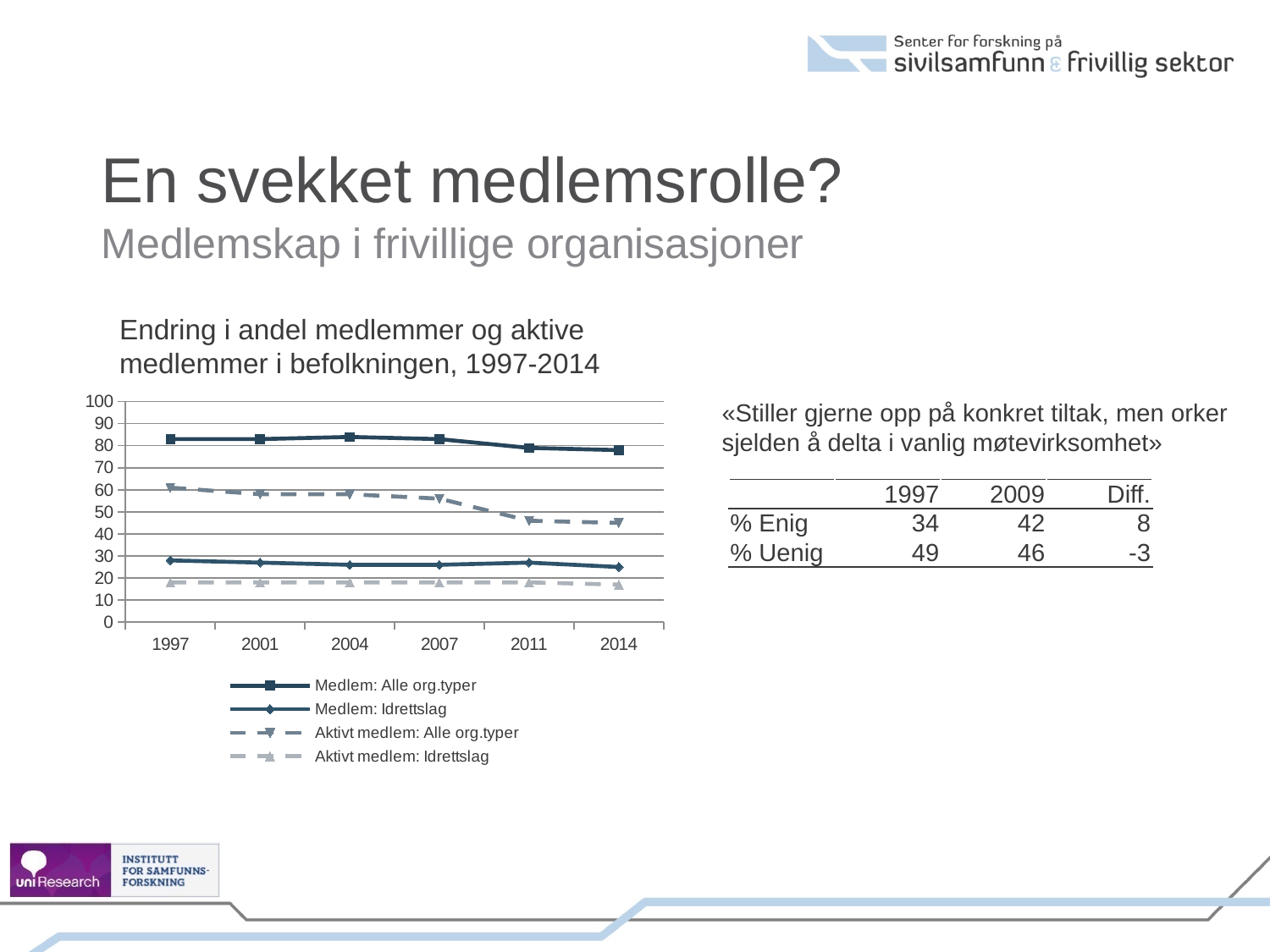
Which series has the lowest values throughout the chart? Aktivt medlem: Idrettslag How many years are shown on the x axis of the chart? 6 What is the title of the chart? Endring i andel medlemmer og aktive medlemmer i befolkningen, 1997-2014 Is the value for 'Aktivt medlem: Alle org.typer' in 2014 greater or less than 50? less How many series does the chart legend list? 4 What is the first year shown on the x axis of the chart? 1997 Which series has the highest values throughout the chart? Medlem: Alle org.typer Does the value for 'Aktivt medlem: Alle org.typer' rise or fall from 1997 to 2014? fall What kind of chart is shown on the slide? line chart Is the value for 'Medlem: Idrettslag' in 2014 greater or less than 30? less Is the value for 'Medlem: Alle org.typer' in 1997 greater or less than 80? greater Which is larger in 2011: 'Medlem: Idrettslag' or 'Aktivt medlem: Idrettslag'? Medlem: Idrettslag